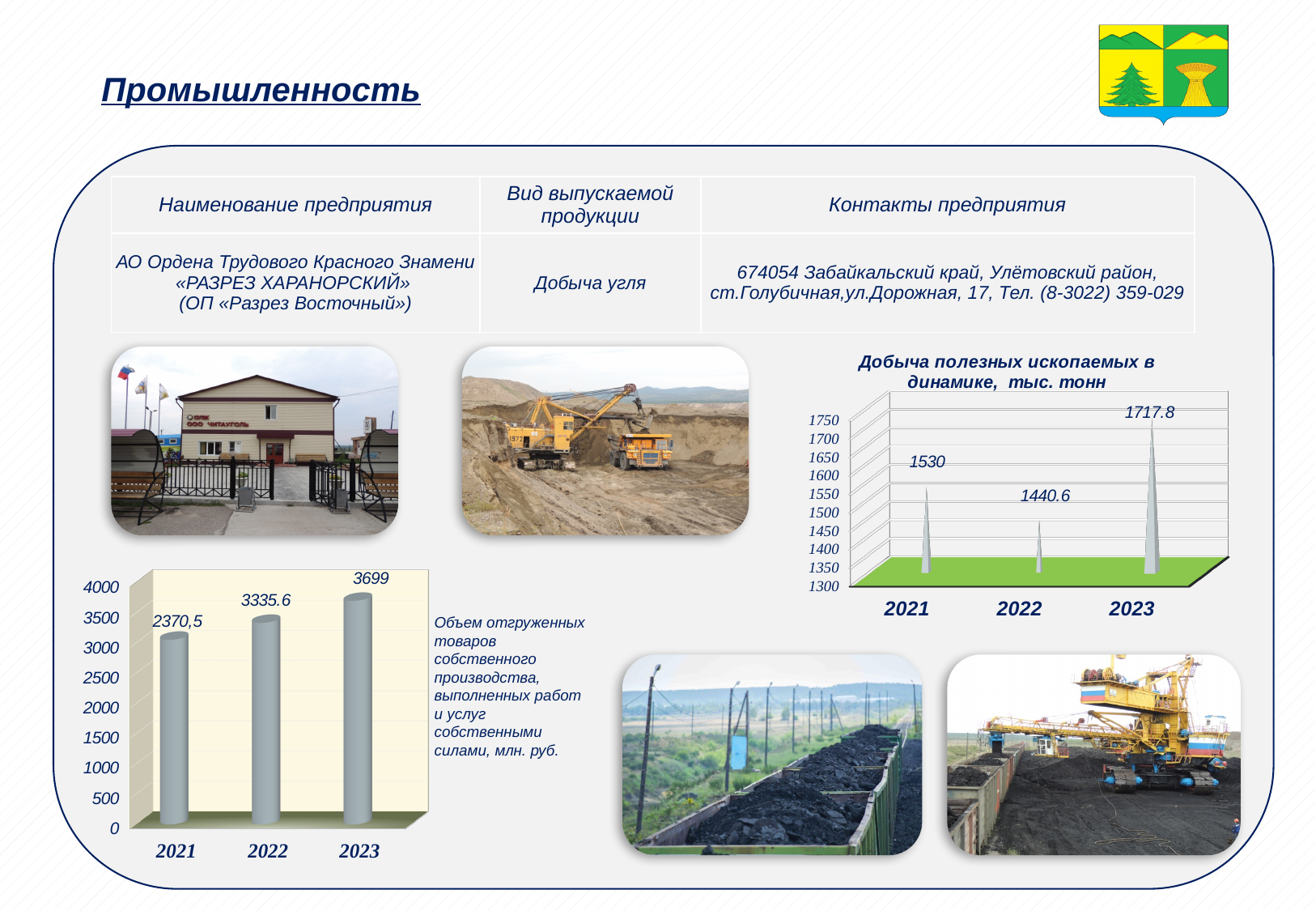
In the bottom-left chart (volume of shipped goods, млн. руб.), what is the value for 2021? 2370,5 In the chart titled "Добыча полезных ископаемых в динамике, тыс. тонн", what is the value for 2022? 1440.6 In the bottom-left chart (volume of shipped goods, млн. руб.), which year has the highest value? 2023 In the chart titled "Добыча полезных ископаемых в динамике, тыс. тонн", what is the value for 2023? 1717.8 In the chart titled "Добыча полезных ископаемых в динамике, тыс. тонн", how many years are shown on the x axis? 3 What kind of chart is the bottom-left chart (volume of shipped goods, млн. руб.)? bar chart In the bottom-left chart (volume of shipped goods, млн. руб.), what is the value for 2023? 3699 In the bottom-left chart (volume of shipped goods, млн. руб.), what is the difference between the 2023 and 2022 values? 363.4 In the chart titled "Добыча полезных ископаемых в динамике, тыс. тонн", which year has the lowest value? 2022 In the chart titled "Добыча полезных ископаемых в динамике, тыс. тонн", is the value for 2021 greater or less than 1500? greater In the bottom-left chart (volume of shipped goods, млн. руб.), do the values rise or fall from 2021 to 2023? rise In the chart titled "Добыча полезных ископаемых в динамике, тыс. тонн", what is the difference between the 2023 and 2022 values? 277.2